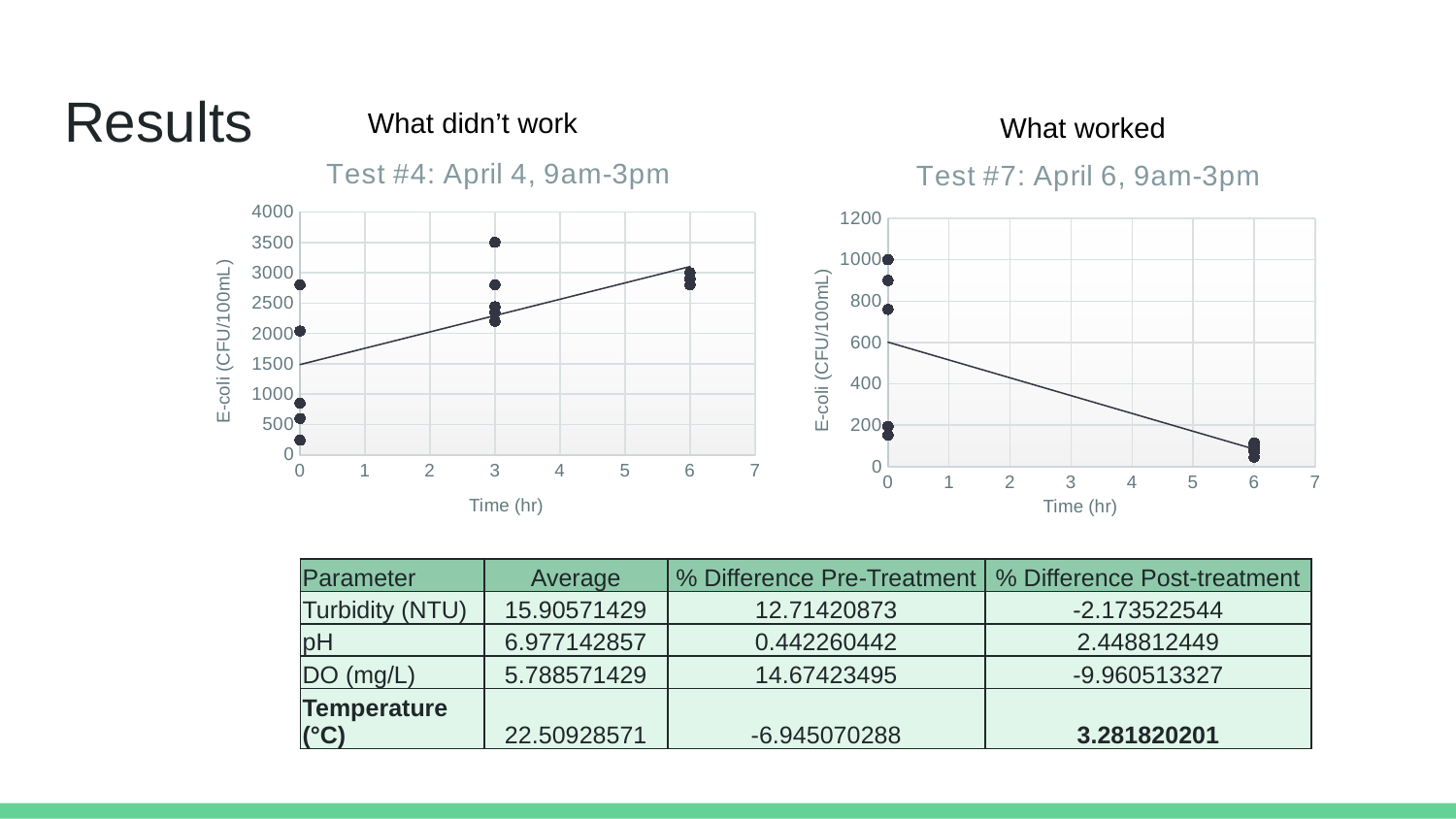
In the 'Test #7: April 6, 9am-3pm' chart, are the E-coli values at 6 hours greater or less than 200? less What is the maximum value shown on the y-axis of the 'Test #4: April 4, 9am-3pm' chart? 4000 In the 'Test #4: April 4, 9am-3pm' chart, does the trend line rise or fall as time increases? rise What kind of chart is the 'Test #4: April 4, 9am-3pm' chart? scatter chart In the 'Test #4: April 4, 9am-3pm' chart, at which time (hr) does the single highest E-coli point occur? 3 In the 'Test #7: April 6, 9am-3pm' chart, does the trend line rise or fall as time increases? fall In the 'Test #4: April 4, 9am-3pm' chart, at how many distinct time points are samples plotted? 3 In the 'Test #7: April 6, 9am-3pm' chart, is the highest E-coli value at 0 hours greater or less than 800? greater In the 'Test #7: April 6, 9am-3pm' chart, are the E-coli values higher at 0 hours or at 6 hours? 0 hours What is the y-axis label on the 'Test #7: April 6, 9am-3pm' chart? E-coli (CFU/100mL) In the 'Test #4: April 4, 9am-3pm' chart, is the highest plotted E-coli value greater or less than 3000? greater